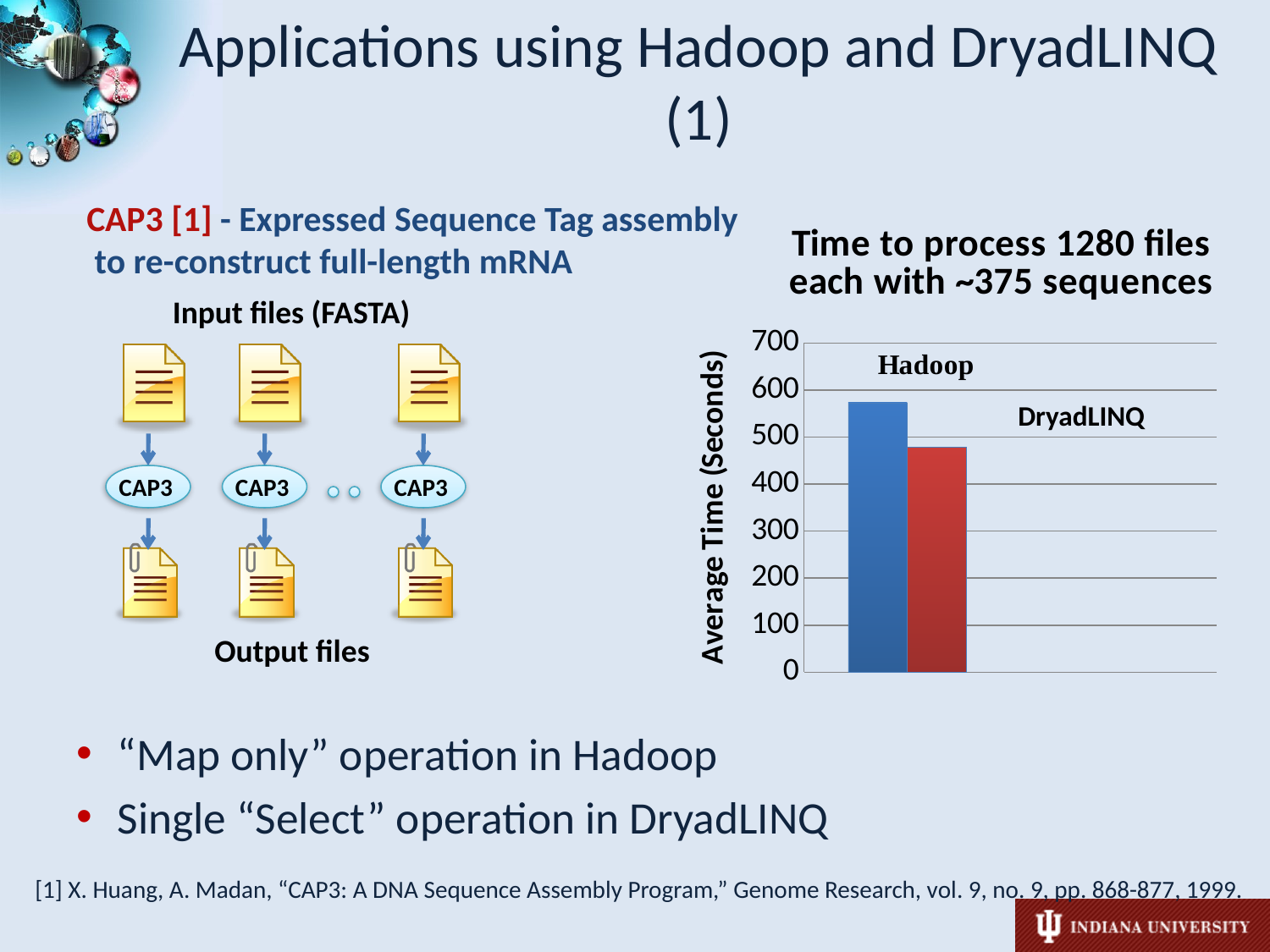
Is the value for Hadoop greater or less than 600? less What is the highest value shown on the vertical axis of the chart? 700 Is the value for DryadLINQ greater or less than 400? greater What is the title of the chart? Time to process 1280 files each with ~375 sequences Is the value for DryadLINQ greater or less than 500? less How many bars are plotted in the chart? 2 Which has the lowest average time in the chart? DryadLINQ What kind of chart is shown on the slide? bar chart Which has the higher average time, Hadoop or DryadLINQ? Hadoop Is the average time for DryadLINQ larger or smaller than that for Hadoop? smaller What is the label of the vertical axis of the chart? Average Time (Seconds)